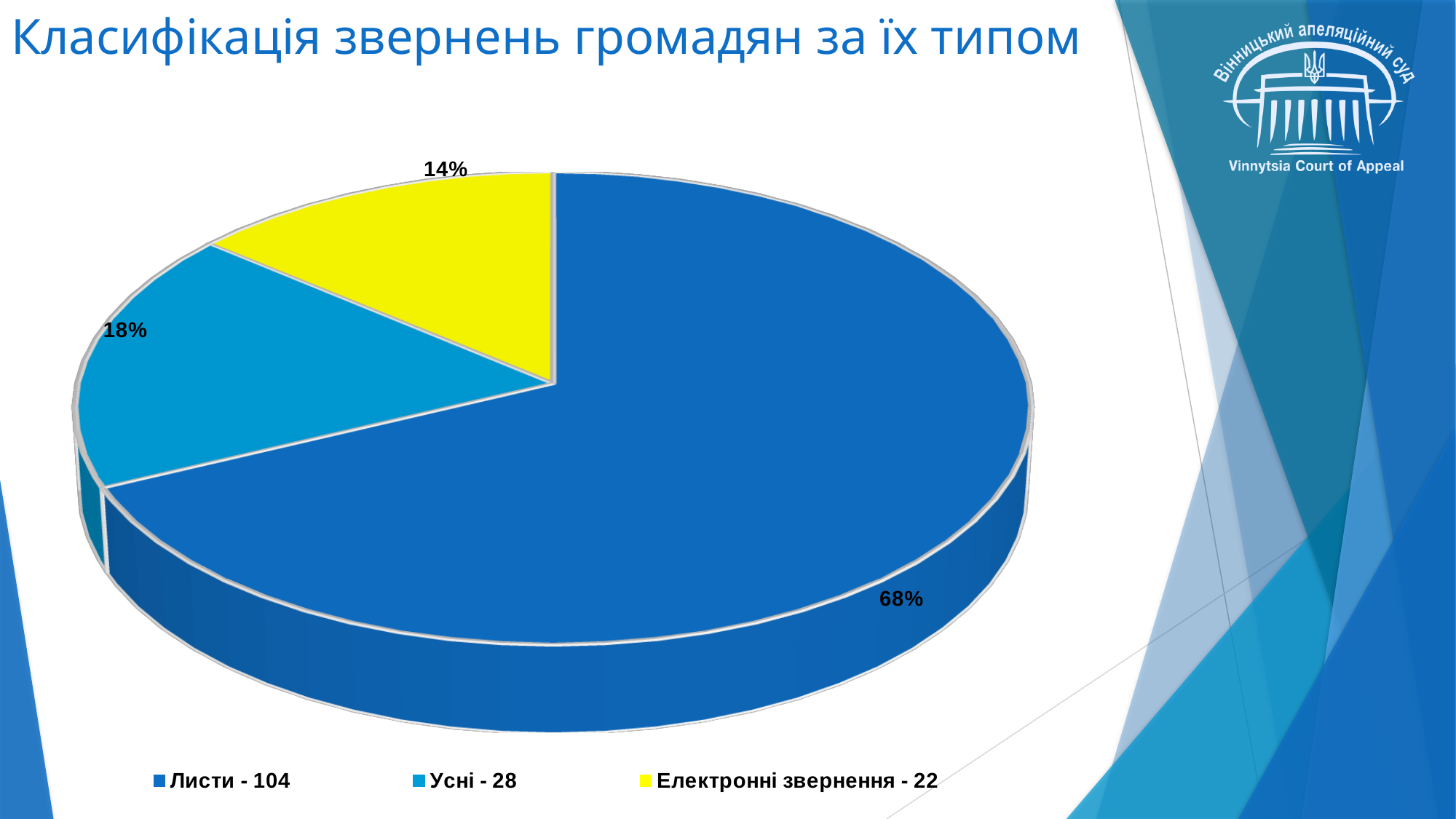
What is the title of the chart? Класифікація звернень громадян за їх типом What kind of chart is shown on the slide? Pie chart Which category has the largest slice of the pie? Листи - 104 What is the difference in percentage points between the "Листи - 104" slice and the "Усні - 28" slice? 50% How many entries does the legend list? 3 What percentage share does the slice for "Електронні звернення - 22" have? 14% How many slices does the pie chart have? 3 What percentage share does the slice for "Листи - 104" have? 68% Which category has the smallest slice of the pie? Електронні звернення - 22 Which slice is larger: "Усні - 28" or "Електронні звернення - 22"? Усні - 28 What percentage share does the slice for "Усні - 28" have? 18% What colour is the slice for "Електронні звернення - 22"? Yellow